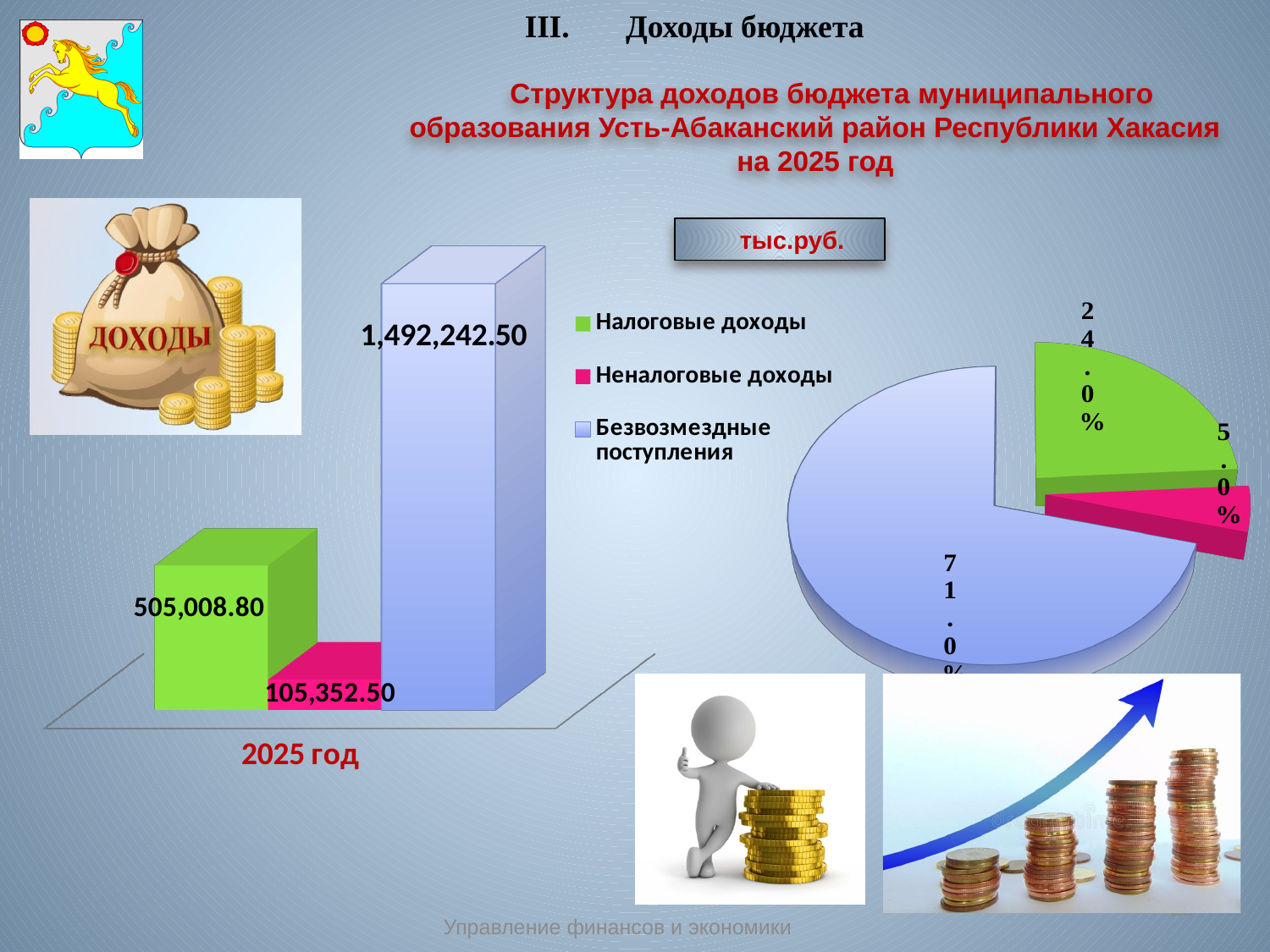
On the bar chart on the left, which series has the highest value? Безвозмездные поступления On the bar chart on the left, what is the value for Неналоговые доходы in 2025 год? 105,352.50 On the bar chart on the left, what is the value for Безвозмездные поступления in 2025 год? 1,492,242.50 What kind of chart is the chart on the right of the slide? Pie chart On the bar chart on the left, what is the difference between Налоговые доходы and Неналоговые доходы? 399,656.30 On the bar chart on the left, which is larger: Налоговые доходы or Безвозмездные поступления? Безвозмездные поступления On the pie chart on the right, what share does the green slice (Налоговые доходы) have? 24.0% On the pie chart on the right, what share does the pink slice (Неналоговые доходы) have? 5.0% On the bar chart on the left, which series has the lowest value? Неналоговые доходы What kind of chart is the chart on the left of the slide? Bar chart How many series does the legend list? 3 On the bar chart on the left, what is the value for Налоговые доходы in 2025 год? 505,008.80